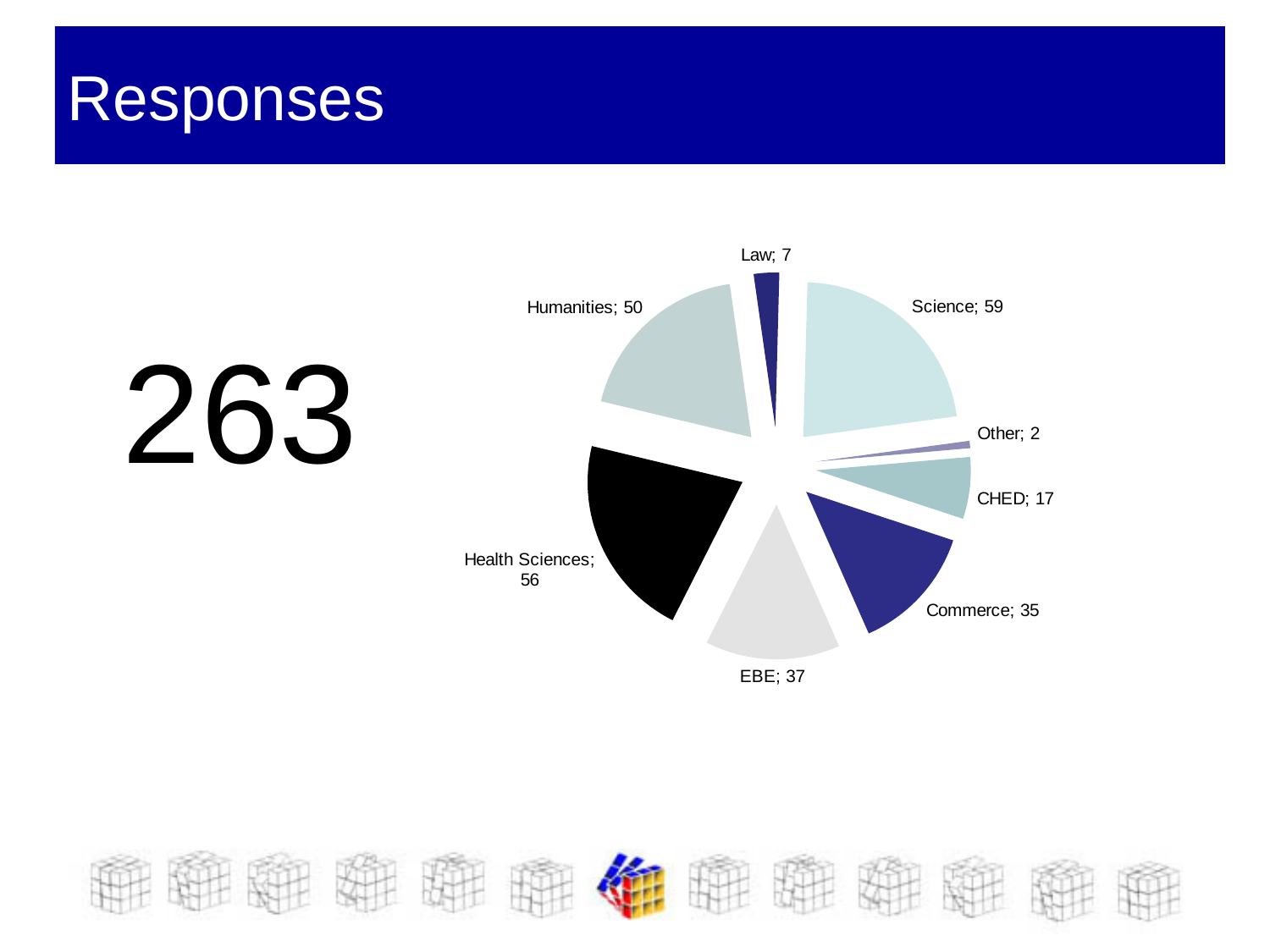
Which is larger, the value for EBE or the value for Commerce? EBE What is the title of the slide containing the pie chart? Responses How many slices does the pie chart have? 8 What kind of chart is shown on the slide? pie chart What is the difference between the values for Science and Health Sciences? 3 What is the value for Law in the pie chart? 7 Which category has the smallest slice in the pie chart? Other What is the difference between the values for Humanities and Commerce? 15 What is the value for Humanities in the pie chart? 50 What is the total of all the slice values in the pie chart? 263 What is the value for CHED in the pie chart? 17 Which category has the largest slice in the pie chart? Science